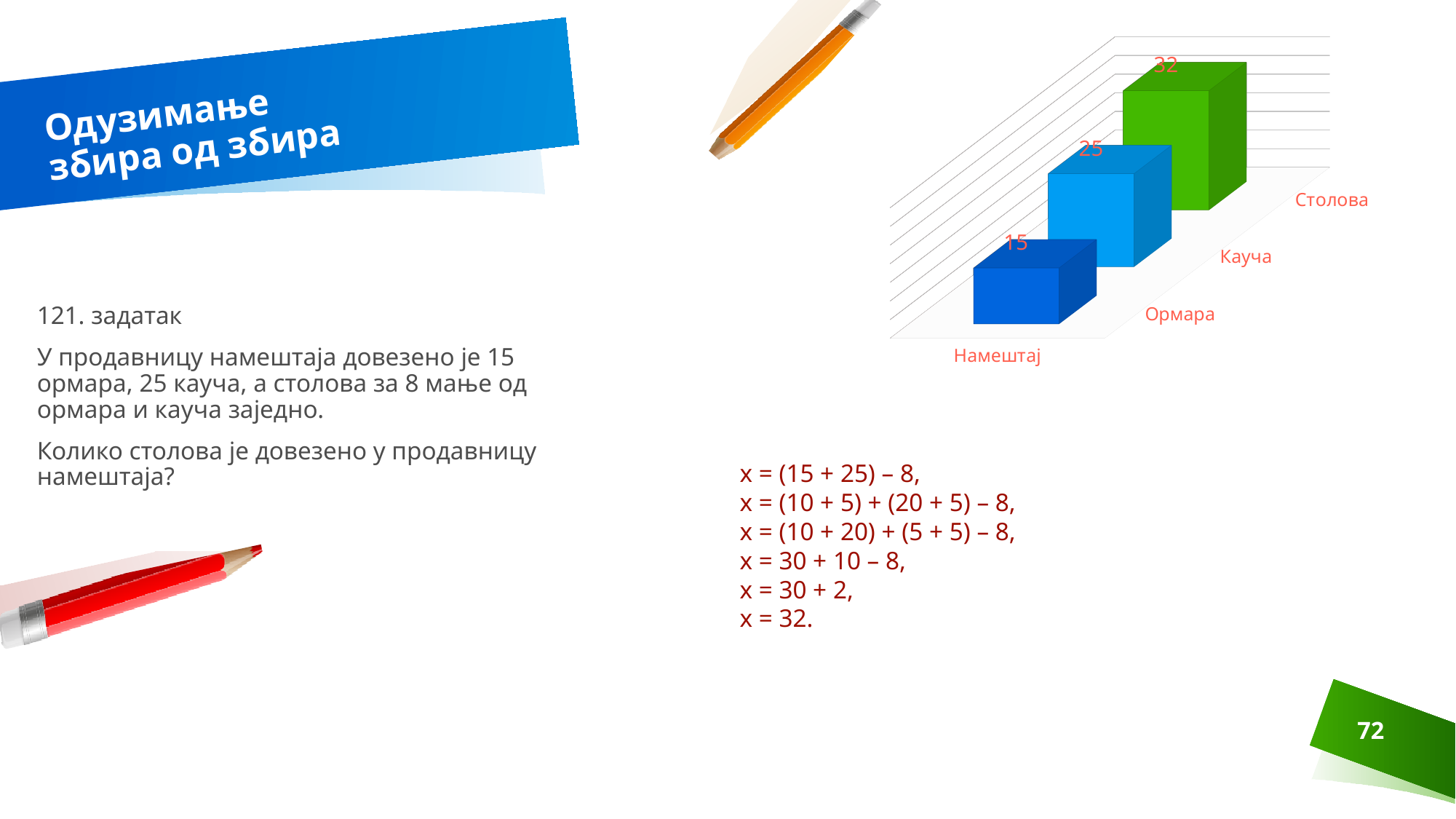
How many categories are shown in the chart? 3 Which is larger, the value for Кауча or the value for Столова? Столова What is the difference between the values for Столова and Ормара? 17 Which category has the lowest value in the chart? Ормара Which category has the highest value in the chart? Столова What is the axis label shown below the categories in the chart? Намештај What is the difference between the values for Кауча and Ормара? 10 What is the value for Ормара in the chart? 15 What is the value for Кауча in the chart? 25 What is the value for Столова in the chart? 32 What kind of chart is shown on the slide? bar chart Do the values rise or fall from Ормара to Столова along the axis? rise